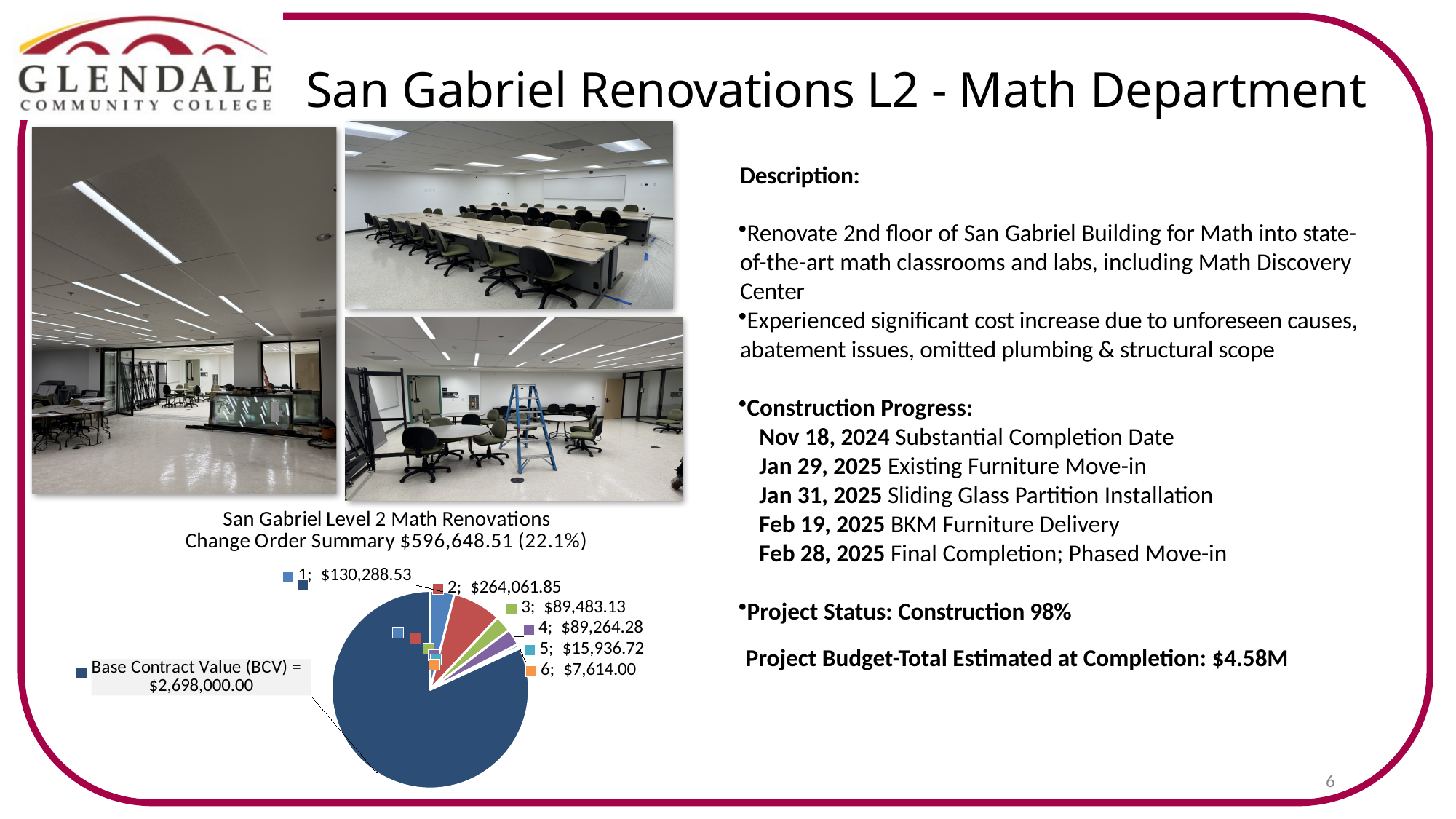
What percentage is shown in parentheses in the chart title? 22.1% Which slice has the smallest value? 6 What is the value of slice 2? $264,061.85 What is the title of the chart? San Gabriel Level 2 Math Renovations Change Order Summary $596,648.51 (22.1%) Which is larger, slice 1 or slice 2? 2 What kind of chart is shown on the slide? pie chart How many slices does the pie chart have? 7 What is the total of slices 1 through 6 (the change orders)? $596,648.51 What is the value of the Base Contract Value (BCV) slice? $2,698,000.00 What is the difference between slice 2 and slice 1? $133,773.32 Which slice has the largest value? Base Contract Value (BCV) What is the value of slice 5? $15,936.72